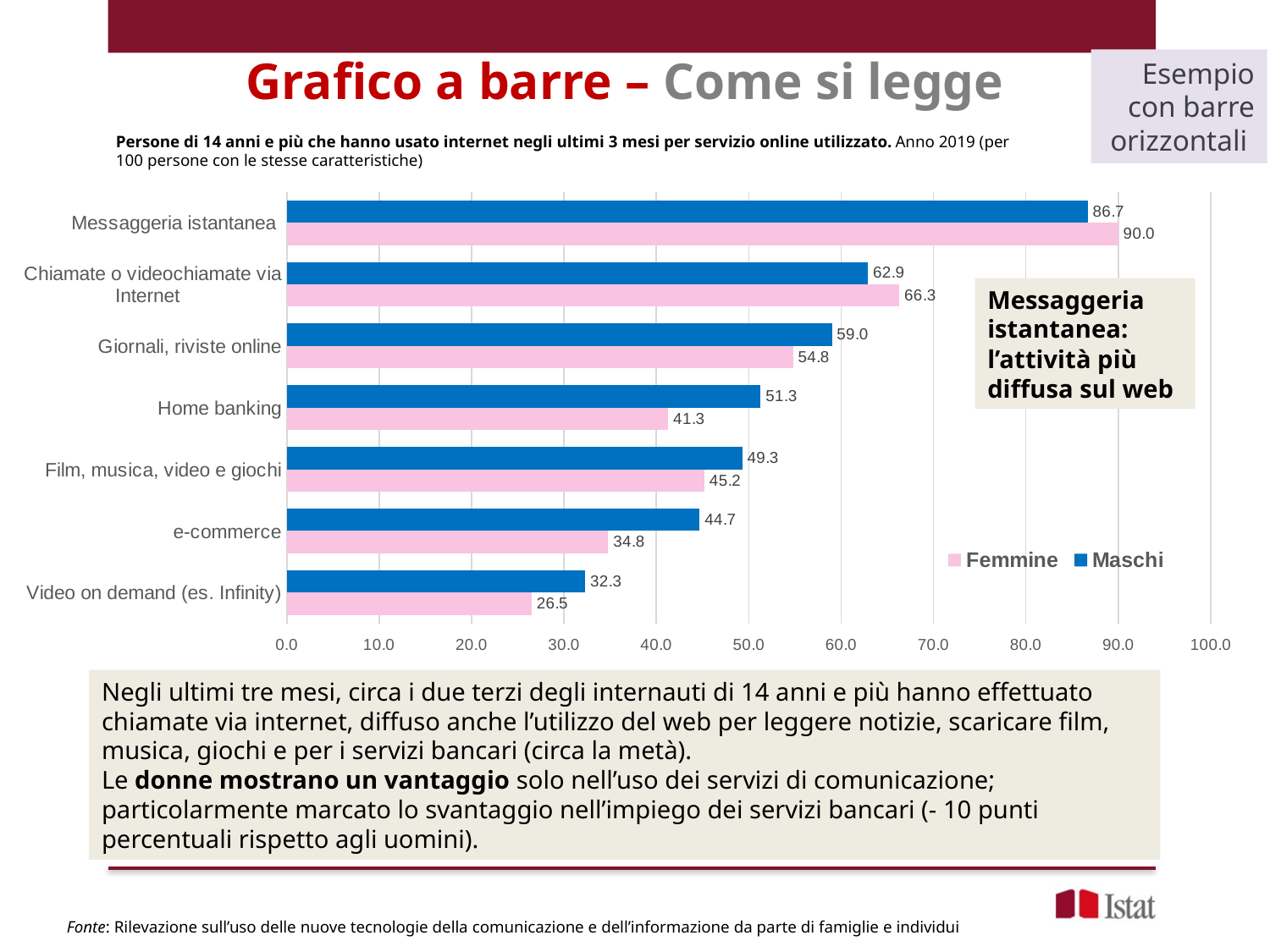
How many series does the legend list? 2 What is the difference between the Maschi and Femmine values for Home banking? 10.0 Which category has the lowest value for Maschi? Video on demand (es. Infinity) What is the value for Maschi for Messaggeria istantanea? 86.7 What kind of chart is shown on the slide? Bar chart What is the value for Maschi for Video on demand (es. Infinity)? 32.3 What is the value for Femmine for e-commerce? 34.8 Which colour represents the Femmine series in the chart? Pink What is the value for Femmine for Home banking? 41.3 How many categories are shown on the chart? 7 For Chiamate o videochiamate via Internet, which is larger: the Femmine value or the Maschi value? Femmine Which category has the highest value for Femmine? Messaggeria istantanea